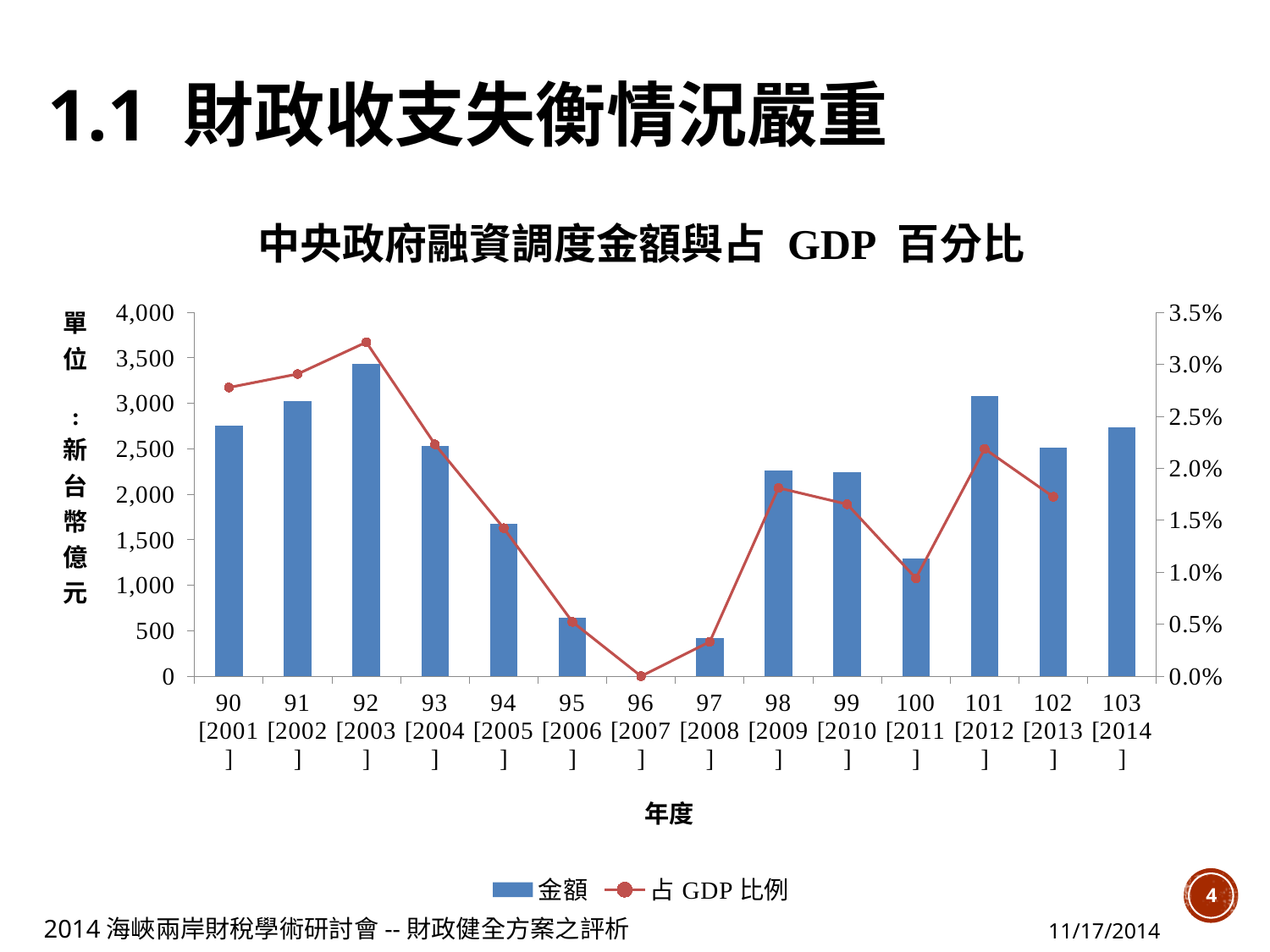
Is the 金額 value for 97 [2008] greater or less than 500? less Does the 占 GDP 比例 line rise or fall from 92 [2003] to 96 [2007]? fall Which year has the highest 占 GDP 比例 value? 92 [2003] Which year has the larger 金額 bar, 91 [2002] or 99 [2010]? 91 [2002] How many series does the legend list? 2 Which year has the lowest 金額 bar? 96 [2007] Is the 金額 value for 90 [2001] greater or less than 2,500? greater What is the 占 GDP 比例 value for 96 [2007]? 0.0% What is the title of the chart? 中央政府融資調度金額與占 GDP 百分比 What kind of chart is shown on the slide? Combination bar and line chart How many years (categories) are plotted on the x axis? 14 Which year has the highest 金額 bar? 92 [2003]